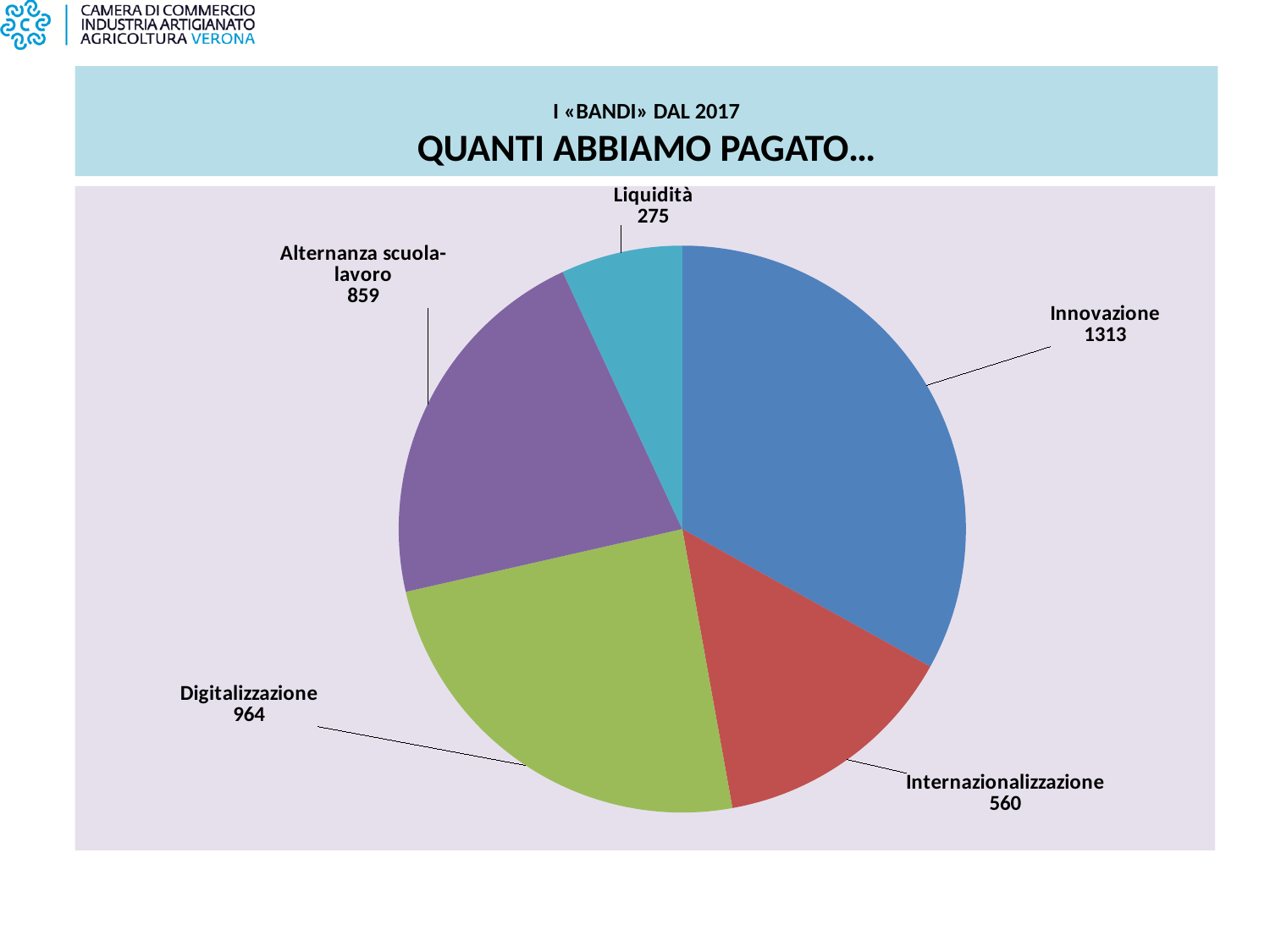
What is the value for Innovazione? 1313 Which category has the highest value? Innovazione Which is larger, the value for Internazionalizzazione or the value for Alternanza scuola-lavoro? Alternanza scuola-lavoro What type of chart is shown on the slide? pie chart What is the value for Alternanza scuola-lavoro? 859 How many slices does the pie chart have? 5 What is the value for Liquidità? 275 What is the title of the slide containing the chart? I «BANDI» DAL 2017 QUANTI ABBIAMO PAGATO... What is the value for Digitalizzazione? 964 Which category has the lowest value? Liquidità What is the difference between the values for Digitalizzazione and Alternanza scuola-lavoro? 105 What is the difference between the values for Innovazione and Internazionalizzazione? 753